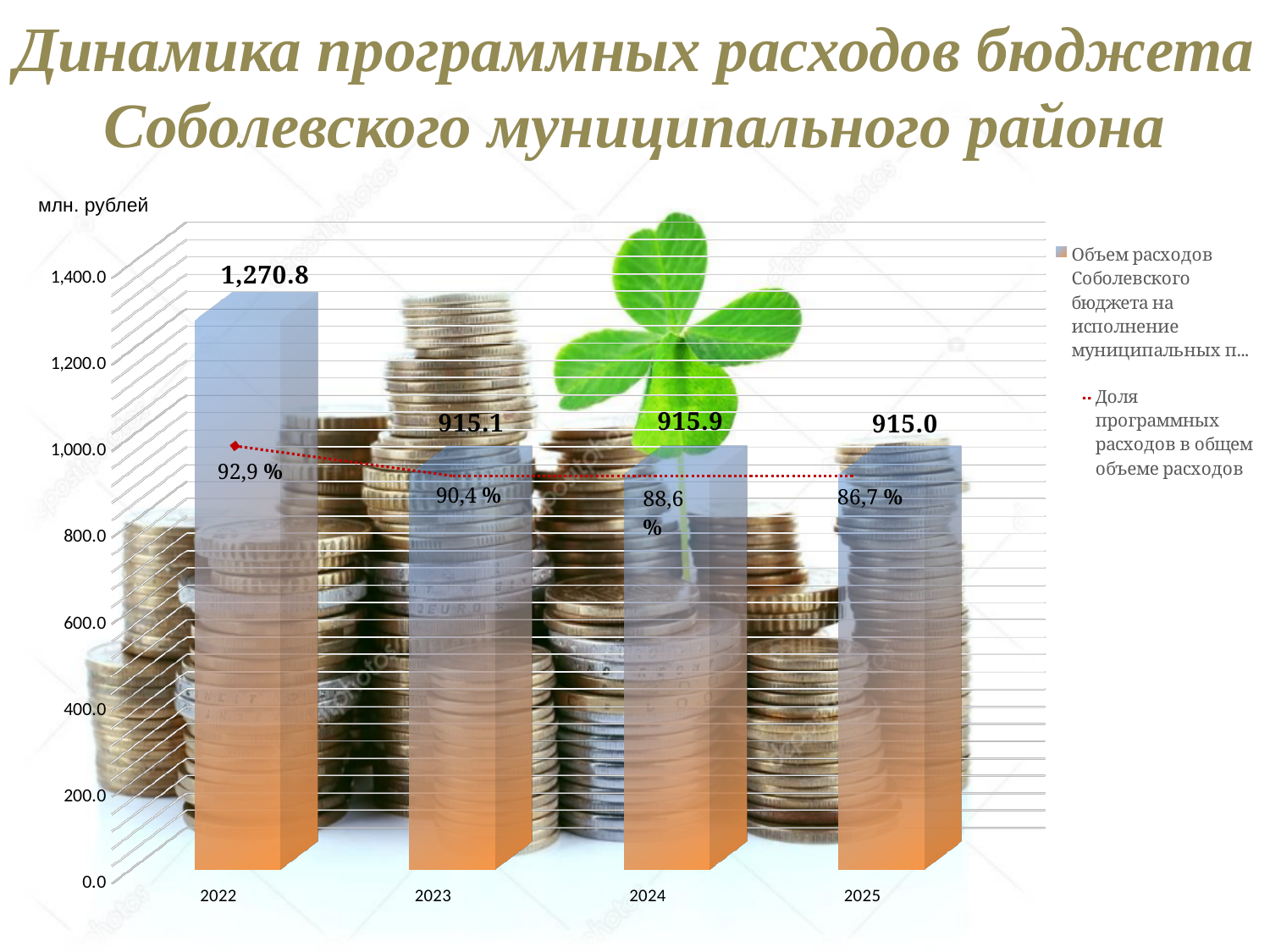
What is the volume of expenditures shown for 2024? 915.9 What is the volume of expenditures of the Sobolevsky budget for municipal programmes in 2022? 1,270.8 Which year has the highest volume of expenditures? 2022 What share of programme expenditures in total expenditures is shown for 2025? 86,7 % How many years are shown on the x axis? 4 Does the share of programme expenditures rise or fall from 2022 to 2025? fall What share of programme expenditures in total expenditures is shown for 2023? 90,4 % What is the difference between the expenditure volume in 2022 and in 2023? 355.7 Which year has the lowest share of programme expenditures in total expenditures? 2025 How many series does the legend list? 2 Which year has the larger expenditure volume, 2024 or 2025? 2024 By how many percentage points does the share of programme expenditures in 2022 exceed that in 2025? 6,2 %